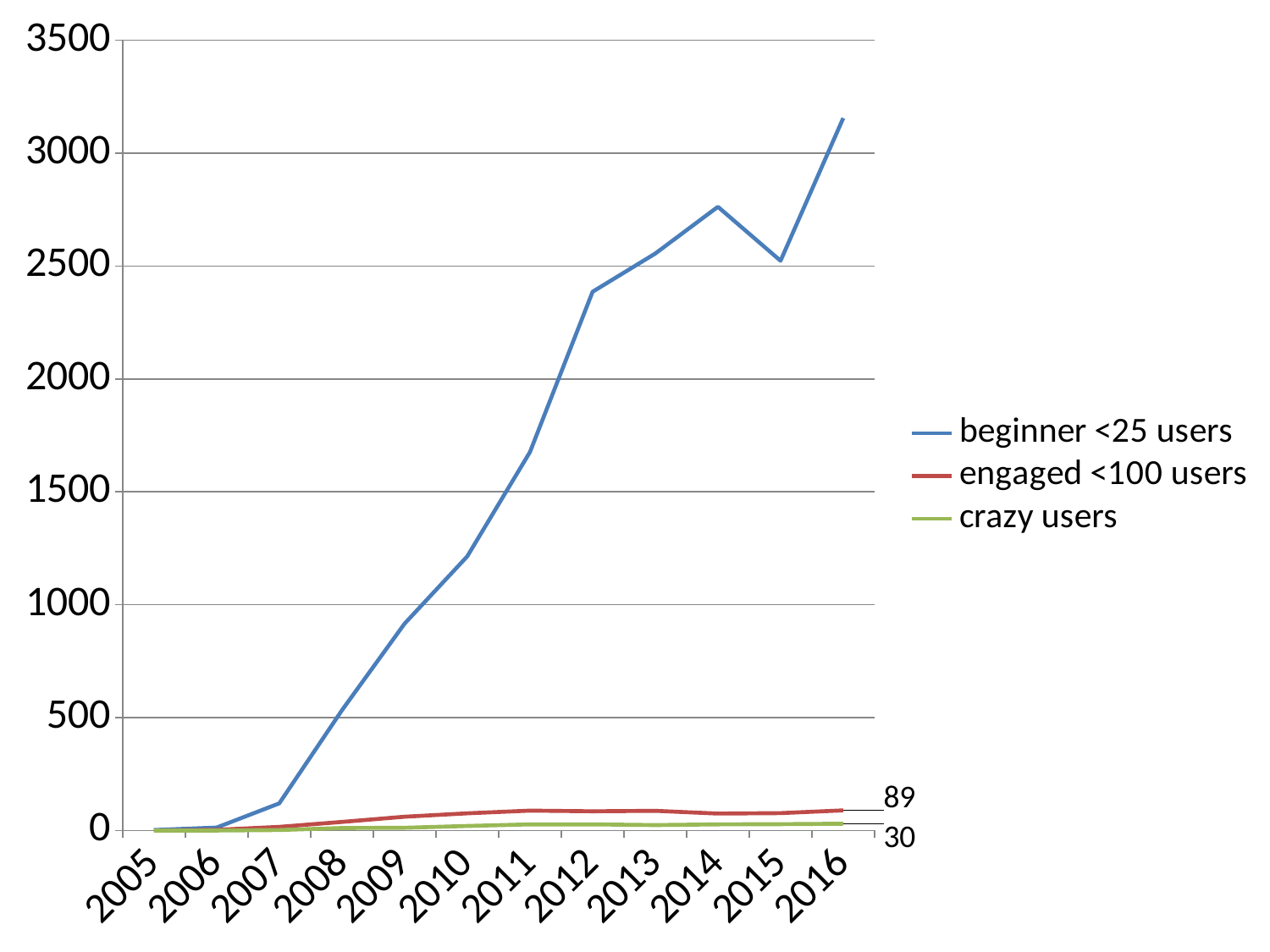
Is the value for beginner <25 users in 2012 greater or less than 2000? greater What kind of chart is shown on the slide? line chart How many series does the legend list? 3 How many years are shown along the x axis? 12 Which series has the highest value in 2016? beginner <25 users Which series is drawn in green? crazy users Is the value for beginner <25 users in 2016 greater or less than 3000? greater What is the value for crazy users in 2016? 30 Which series has the lowest value in 2016? crazy users In which year does the beginner <25 users series first exceed 1000? 2010 What is the difference between engaged <100 users and crazy users in 2016? 59 What is the value for engaged <100 users in 2016? 89